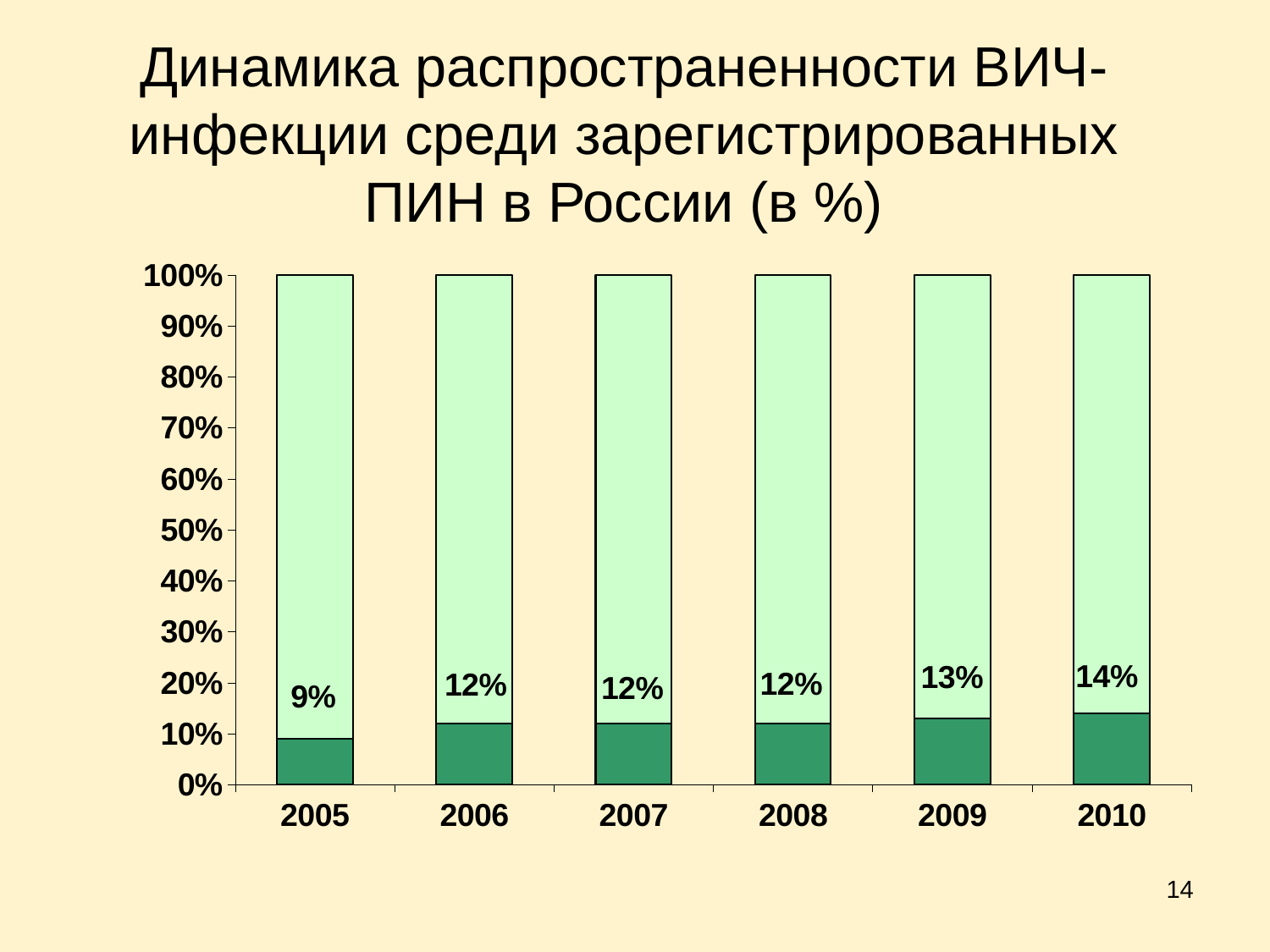
What is the HIV prevalence value shown for 2005? 9% What is the value shown for 2010? 14% What is the difference between the labelled values for 2010 and 2005? 5% How many years are shown on the x axis? 6 What is the value shown for 2009? 13% Which year has the larger labelled value, 2009 or 2005? 2009 What kind of chart is shown on the slide? Stacked bar chart Which year has the lowest labelled value? 2005 Do the labelled values rise or fall from 2005 to 2010? Rise Which year has the highest labelled value? 2010 Is the dark green value for 2005 greater or less than 10%? less What is the total height of each stacked bar? 100%